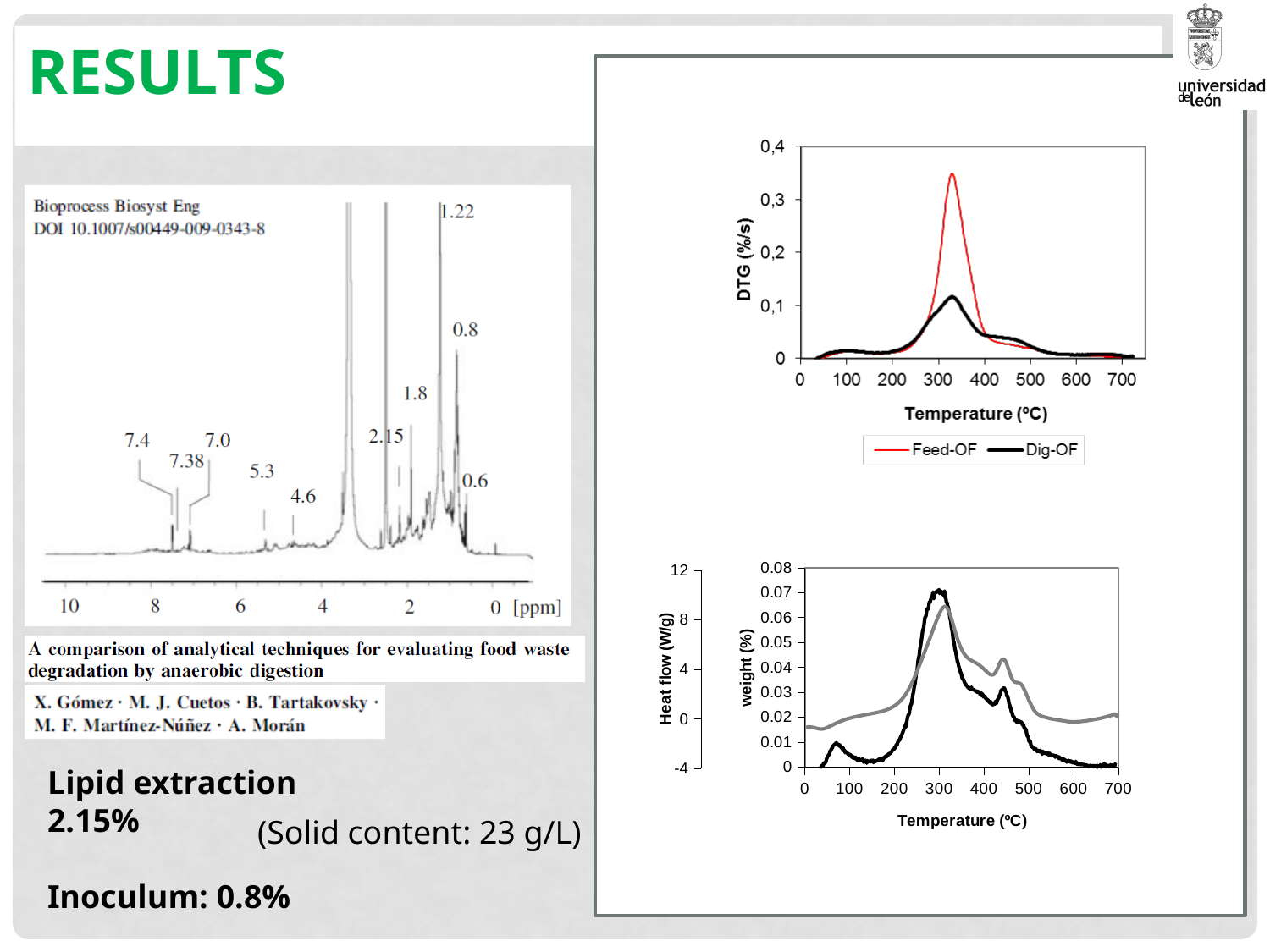
In the top right chart, what is the label of the y axis? DTG (%/s) In the bottom right chart (Heat flow / weight vs Temperature), is the peak of the black line greater or less than 0.06 on the weight (%) axis? greater In the top right chart (DTG vs Temperature), which series reaches the higher peak DTG value? Feed-OF In the NMR spectrum on the left, how many peaks are labelled with a ppm value? 10 In the bottom right chart (Heat flow / weight vs Temperature), what is the highest value shown on the Heat flow (W/g) axis? 12 In the top right chart (DTG vs Temperature), what are the names of the two series in the legend? Feed-OF and Dig-OF In the NMR spectrum on the left, what is the highest labelled peak position in ppm? 7.4 In the top right chart (DTG vs Temperature), how many series does the legend list? 2 What kind of chart is the top right chart (DTG vs Temperature)? Line chart In the top right chart (DTG vs Temperature), is the peak value of Feed-OF greater or less than 0,3 %/s? greater In the bottom right chart (Heat flow / weight vs Temperature), what is the highest value shown on the weight (%) axis? 0.08 In the top right chart (DTG vs Temperature), is the peak value of Dig-OF greater or less than 0,2 %/s? less